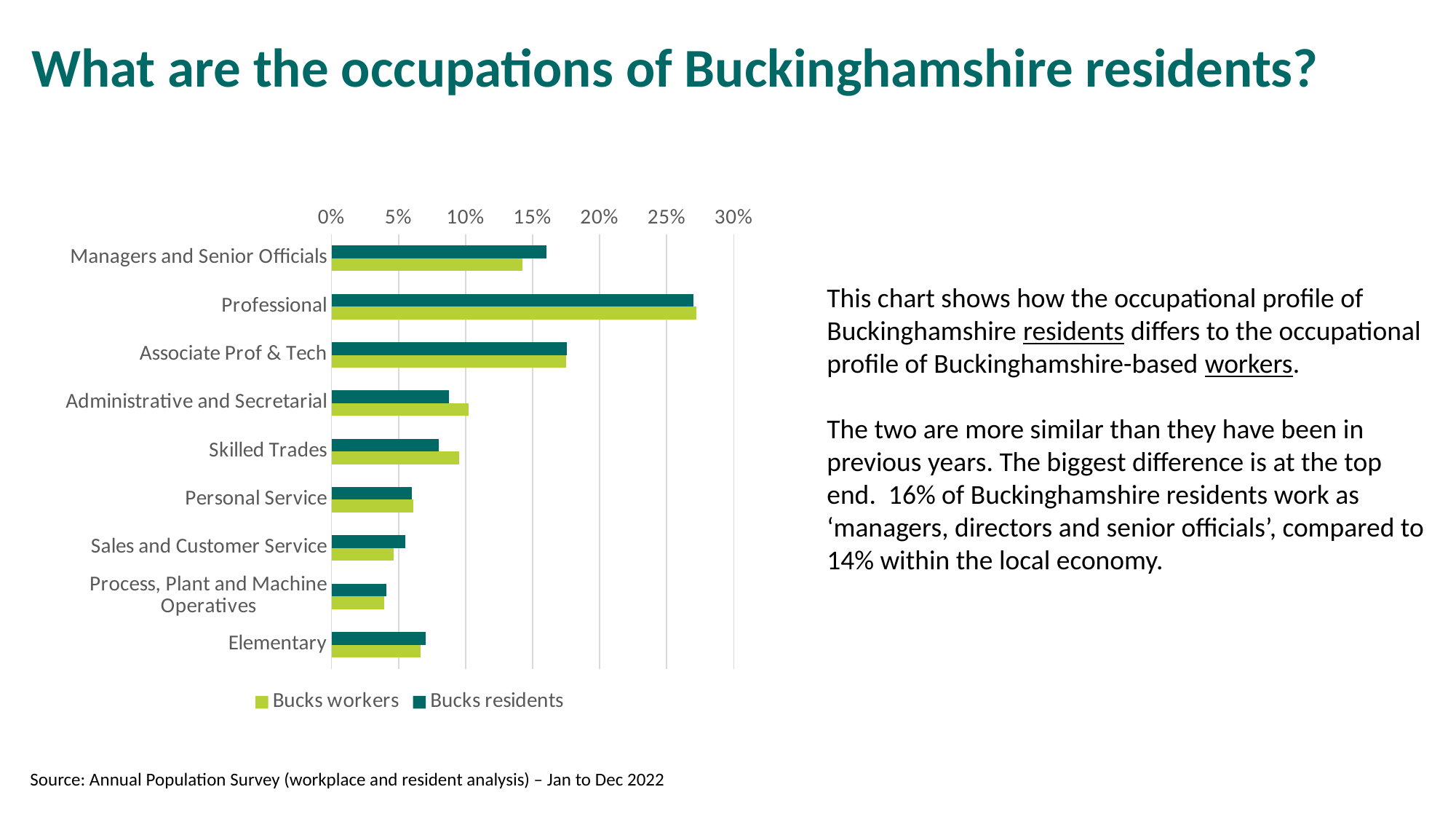
Is the Bucks residents value for Elementary greater or less than 5%? greater What are the two series named in the chart legend? Bucks workers and Bucks residents Is the Bucks workers value for Managers and Senior Officials greater or less than 15%? less What kind of chart is shown on the slide? bar chart How many occupation categories are shown on the chart? 9 For Administrative and Secretarial, which is larger: the Bucks workers value or the Bucks residents value? Bucks workers For Managers and Senior Officials, which is larger: the Bucks workers value or the Bucks residents value? Bucks residents Which occupation category has the highest value for Bucks residents? Professional How many series does the chart legend list? 2 Is the Bucks residents value for Professional greater or less than 25%? greater Which occupation category has the lowest value for Bucks residents? Process, Plant and Machine Operatives